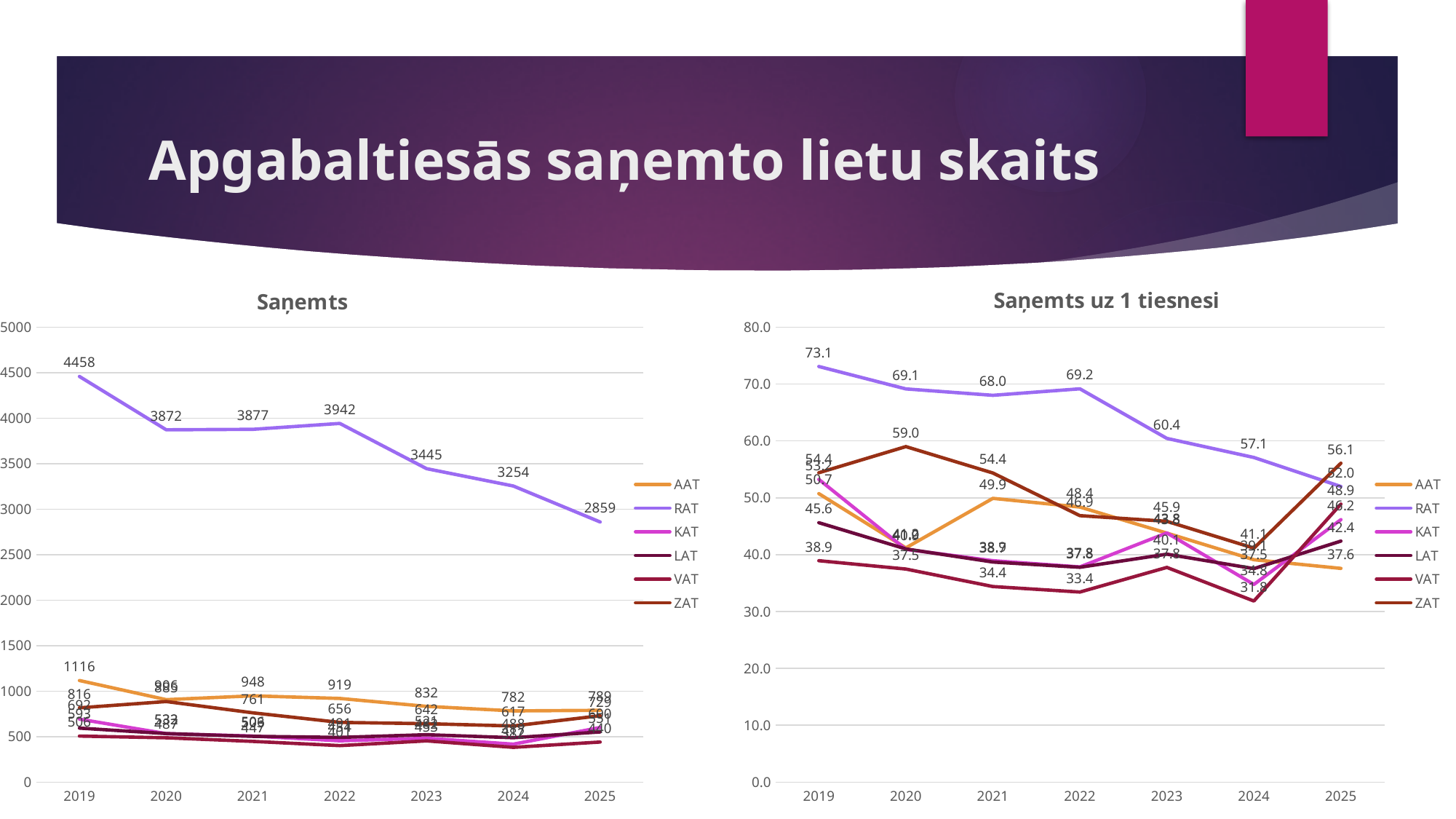
In the "Saņemts" chart, which series has the highest values across all years? RAT How many series does the legend of the "Saņemts uz 1 tiesnesi" chart list? 6 In the "Saņemts uz 1 tiesnesi" chart, which is larger in 2021: RAT or AAT? RAT What type of chart is the "Saņemts" chart? line chart In the "Saņemts" chart, what is the difference between the RAT values in 2019 and 2025? 1599 In the "Saņemts uz 1 tiesnesi" chart, what is the value for ZAT in 2020? 59.0 In the "Saņemts" chart, what is the value for AAT in 2019? 1116 In the "Saņemts" chart, does the RAT series generally rise or fall from 2019 to 2025? fall In the "Saņemts uz 1 tiesnesi" chart, what is the value for RAT in 2019? 73.1 In the "Saņemts" chart, what is the value for RAT in 2019? 4458 In the "Saņemts" chart, what is the value for RAT in 2025? 2859 In the "Saņemts uz 1 tiesnesi" chart, what is the value for VAT in 2024? 31.8